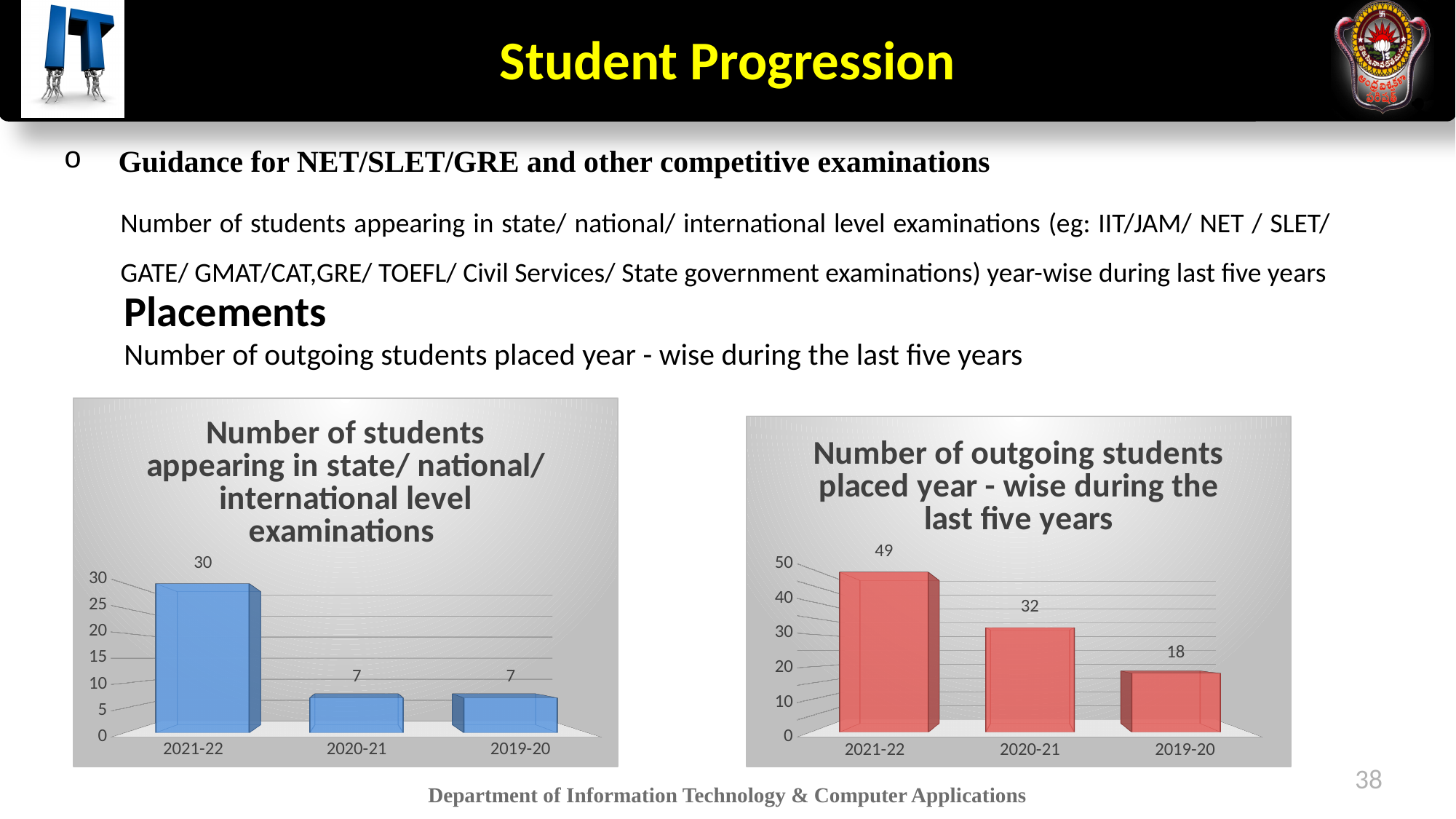
In the right chart (Number of outgoing students placed year - wise during the last five years), which year has the lowest value? 2019-20 In the left chart (Number of students appearing in state/ national/ international level examinations), what is the value for 2020-21? 7 In the left chart (Number of students appearing in state/ national/ international level examinations), how many years are shown on the x axis? 3 In the right chart (Number of outgoing students placed year - wise during the last five years), what is the value for 2021-22? 49 In the left chart (Number of students appearing in state/ national/ international level examinations), which year has the highest value? 2021-22 In the right chart (Number of outgoing students placed year - wise during the last five years), what is the difference between the values for 2021-22 and 2020-21? 17 In the right chart (Number of outgoing students placed year - wise during the last five years), what is the value for 2019-20? 18 In the right chart (Number of outgoing students placed year - wise during the last five years), which is larger, the value for 2020-21 or 2019-20? 2020-21 What kind of chart is the right chart (Number of outgoing students placed year - wise during the last five years)? bar chart In the right chart (Number of outgoing students placed year - wise during the last five years), do the values rise or fall from 2021-22 to 2019-20 along the x axis? fall In the left chart (Number of students appearing in state/ national/ international level examinations), what is the value for 2021-22? 30 In the left chart (Number of students appearing in state/ national/ international level examinations), what is the difference between the values for 2021-22 and 2019-20? 23